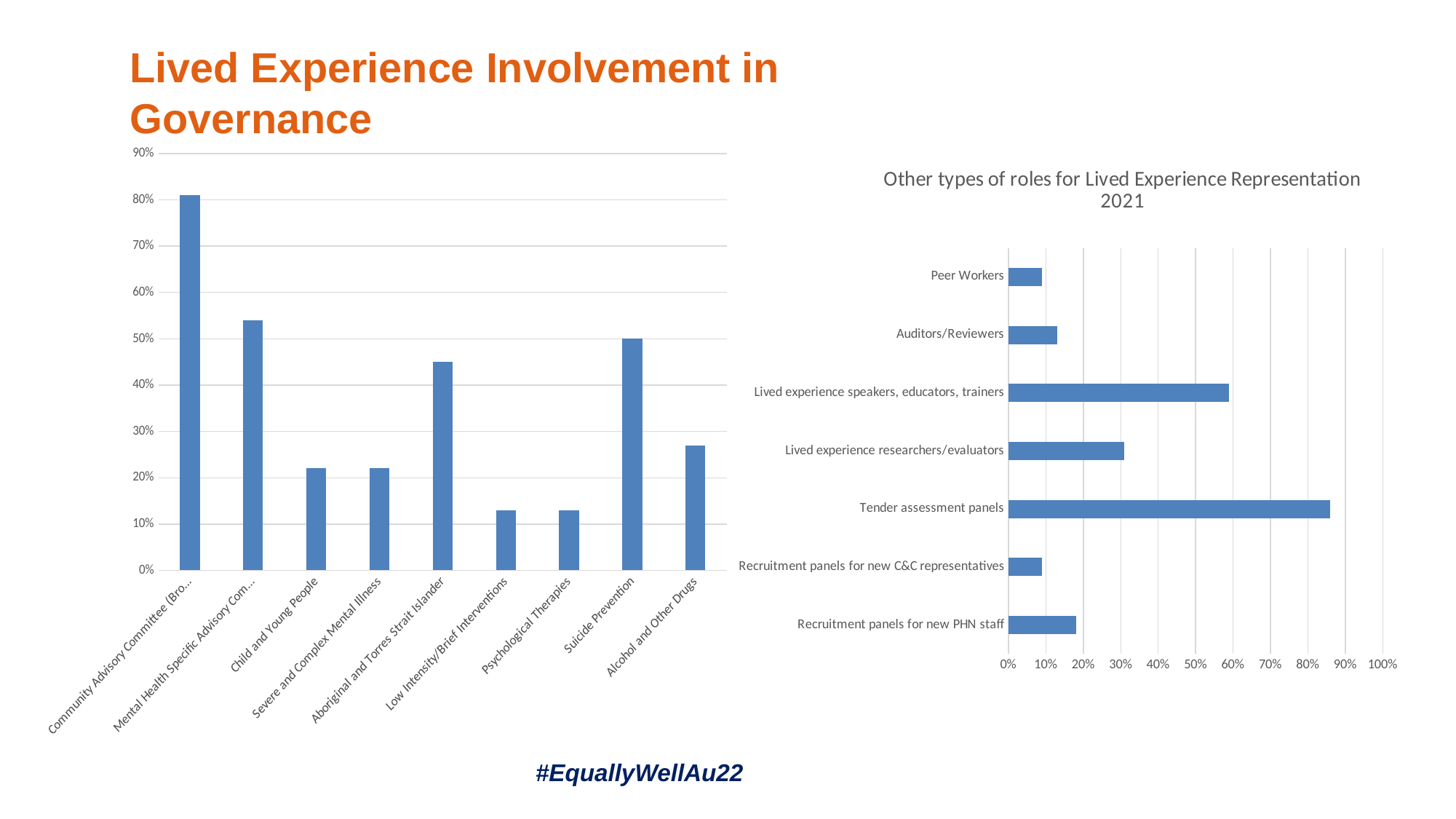
In the chart on the left of the slide, is the value for Alcohol and Other Drugs greater or less than 30%? less In the chart titled 'Other types of roles for Lived Experience Representation 2021', which role has the highest value? Tender assessment panels What kind of chart is the chart on the left of the slide? bar chart In the chart titled 'Other types of roles for Lived Experience Representation 2021', which is larger: Lived experience researchers/evaluators or Auditors/Reviewers? Lived experience researchers/evaluators In the chart on the left of the slide, which category has the highest value? Community Advisory Committee (Bro... In the chart titled 'Other types of roles for Lived Experience Representation 2021', is the value for Recruitment panels for new PHN staff greater or less than 20%? less In the chart titled 'Other types of roles for Lived Experience Representation 2021', is the value for Lived experience speakers, educators, trainers greater or less than 50%? greater In the chart on the left of the slide, how many categories are shown? 9 In the chart on the left of the slide, which is larger: Mental Health Specific Advisory Com... or Child and Young People? Mental Health Specific Advisory Com... In the chart titled 'Other types of roles for Lived Experience Representation 2021', how many roles are listed? 7 What kind of chart is the chart titled 'Other types of roles for Lived Experience Representation 2021'? bar chart